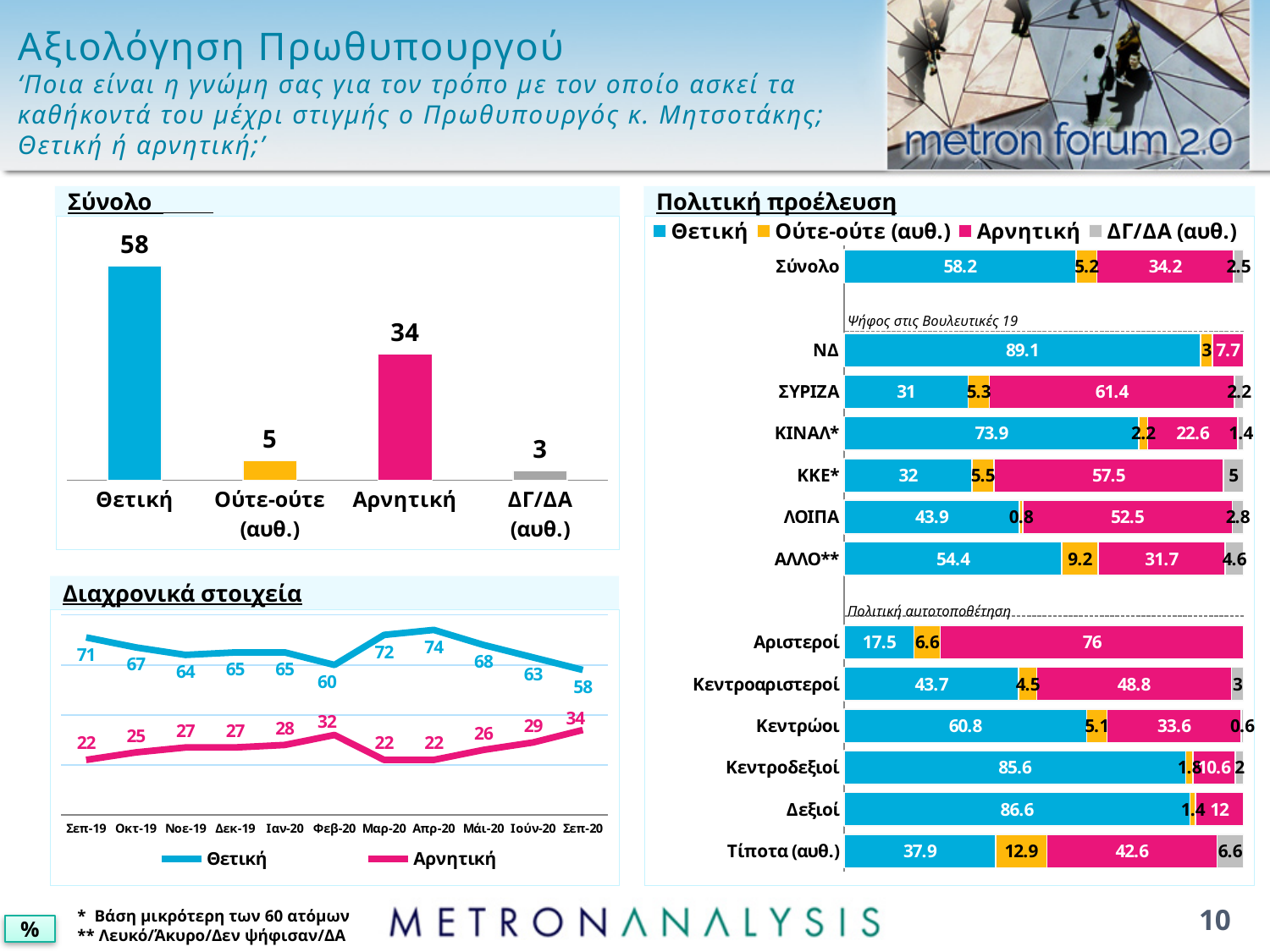
In the 'Πολιτική προέλευση' chart, which group has the highest Αρνητική value? Αριστεροί How many series does the legend of the 'Πολιτική προέλευση' chart list? 4 In the 'Διαχρονικά στοιχεία' chart, what is the value of Θετική for Απρ-20? 74 In the 'Σύνολο' chart, which category has the lowest value? ΔΓ/ΔΑ (αυθ.) In the 'Διαχρονικά στοιχεία' chart, how many time points are shown on the x axis? 11 In the 'Πολιτική προέλευση' chart, what is the Θετική value for ΝΔ? 89.1 In the 'Διαχρονικά στοιχεία' chart, does the Αρνητική series rise or fall from Μάι-20 to Σεπ-20? Rise In the 'Σύνολο' chart, what is the difference between Θετική and Αρνητική? 24 In the 'Σύνολο' chart, what is the value for Θετική? 58 In the 'Πολιτική προέλευση' chart, what is the Ούτε-ούτε (αυθ.) value for Τίποτα (αυθ.)? 12.9 What kind of chart is the 'Σύνολο' chart? Bar chart In the 'Διαχρονικά στοιχεία' chart, which series is higher at Φεβ-20, Θετική or Αρνητική? Θετική